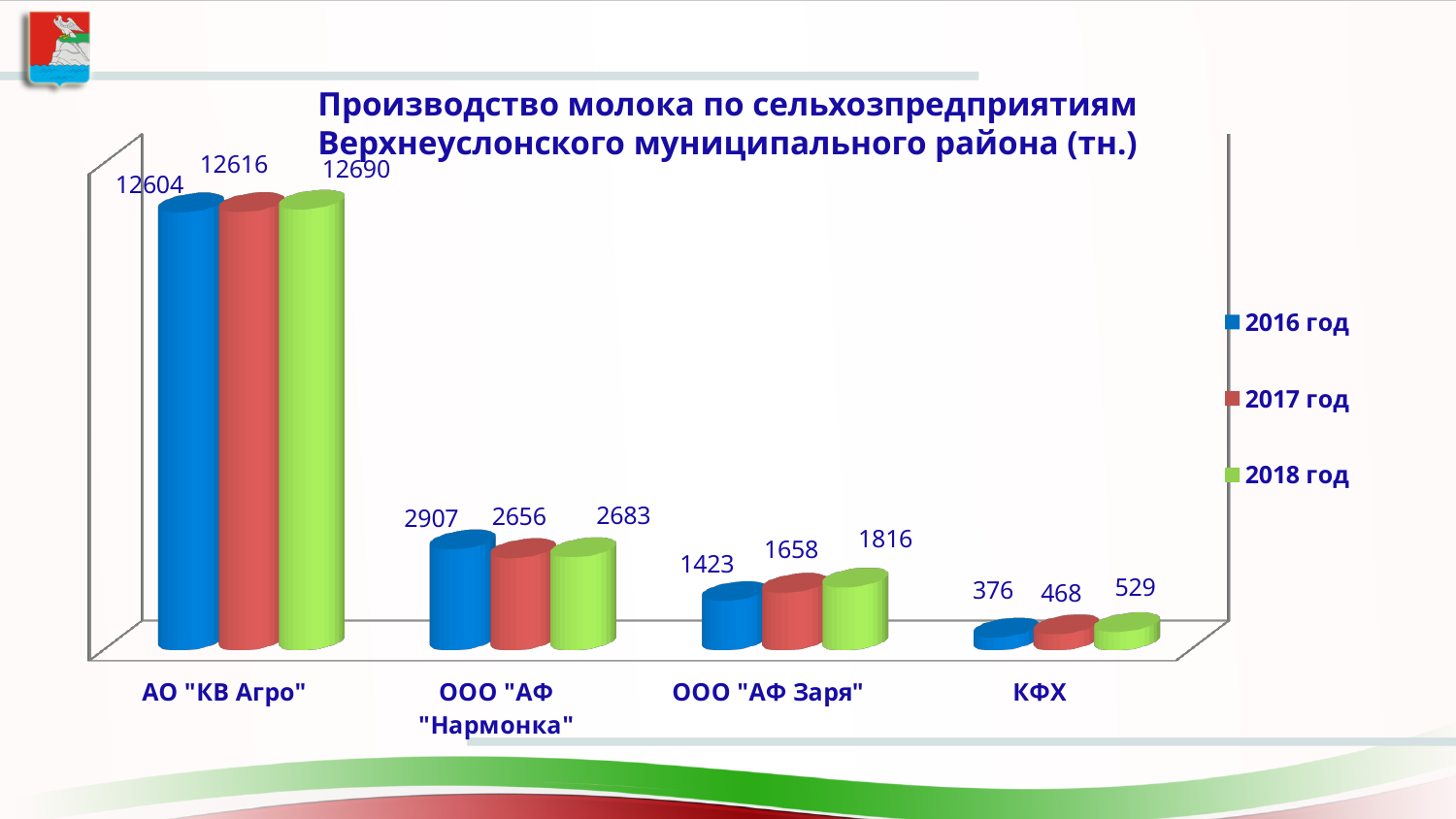
What kind of chart is shown on the slide? Bar chart Which enterprise had the lowest milk production in 2016? КФХ Which is larger for ООО "АФ "Нармонка": the 2016 value or the 2018 value? 2016 value Which colour represents 2017 год in the legend? Red What is the difference between the 2018 and 2016 values for ООО "АФ Заря"? 393 What was milk production for ООО "АФ Заря" in 2016? 1423 How many enterprises are shown on the x axis? 4 What was milk production for АО "КВ Агро" in 2018? 12690 Do the values for КФХ rise or fall from 2016 to 2018? Rise Which enterprise had the highest milk production in 2017? АО "КВ Агро" What was milk production for КФХ in 2017? 468 How many series does the legend list? 3